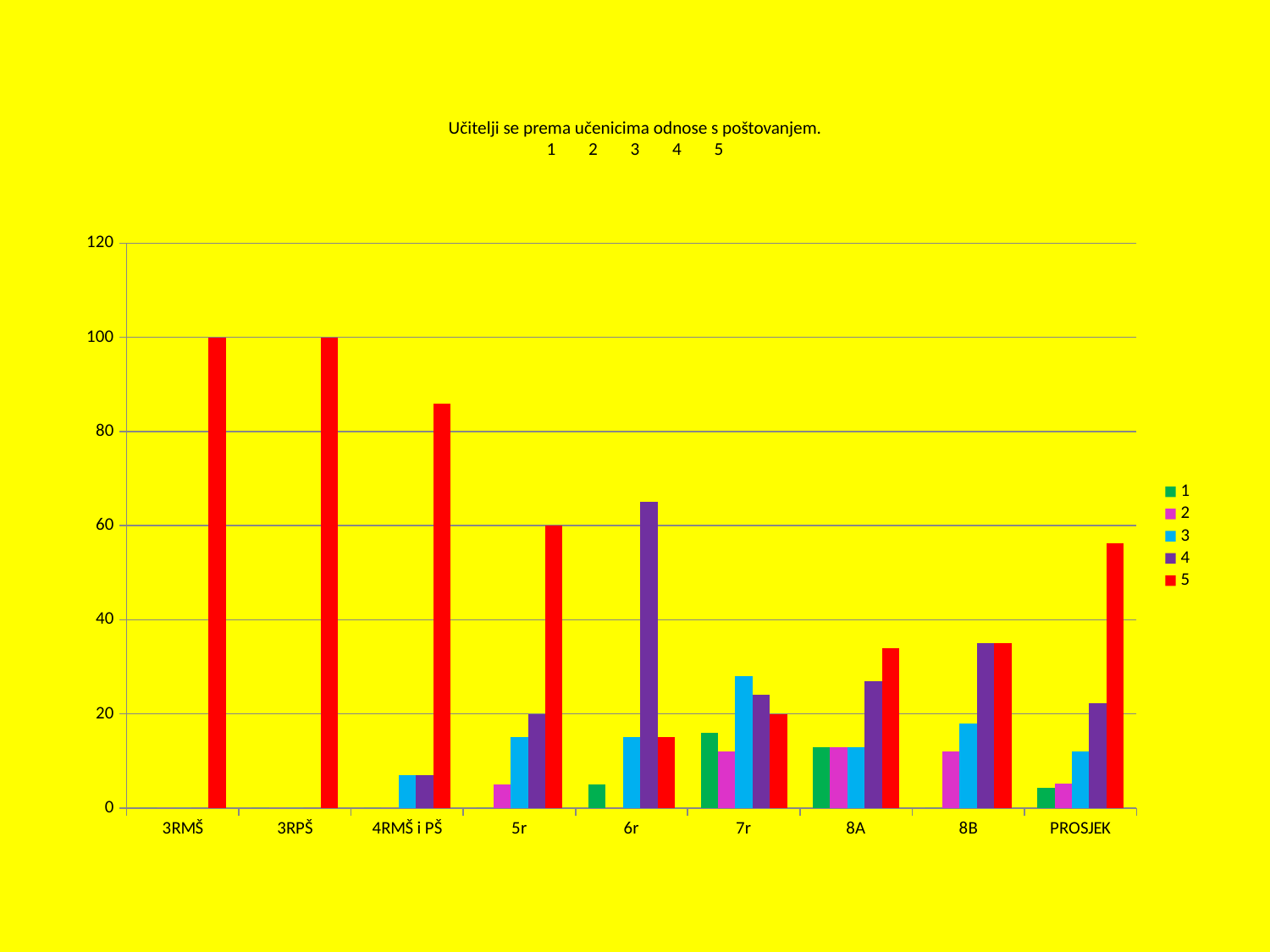
Is the value of series 5 for 4RMŠ i PŠ greater or less than 80? greater Which series is shown in red in the legend? 5 Which category has the highest value for series 4? 6r What is the value of series 5 for 5r? 60 Is the value of series 5 for PROSJEK greater or less than 60? less How many series does the legend list? 5 What kind of chart is shown on the slide? bar chart What is the value of series 5 for 3RMŠ? 100 What is the value of series 4 for 5r? 20 Is the value of series 4 for 6r greater or less than 60? greater How many categories are shown on the x axis? 9 For 7r, which is larger: series 3 or series 5? series 3